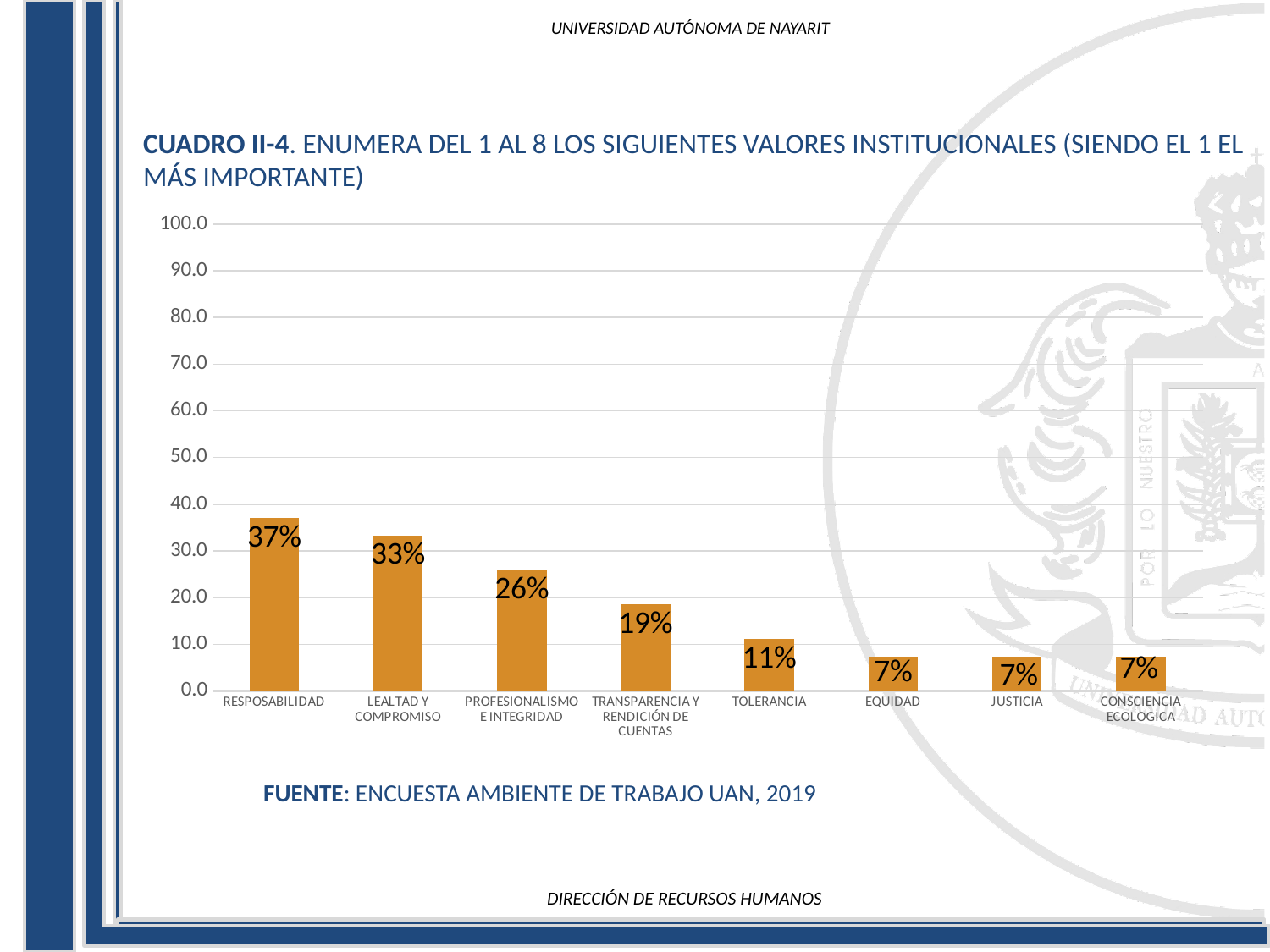
What is the source cited below the chart? ENCUESTA AMBIENTE DE TRABAJO UAN, 2019 What is the value for TRANSPARENCIA Y RENDICIÓN DE CUENTAS? 19% Which category has the highest value? RESPOSABILIDAD What kind of chart is shown on the slide? bar chart How many categories are shown on the x axis? 8 Which is larger, the value for LEALTAD Y COMPROMISO or the value for PROFESIONALISMO E INTEGRIDAD? LEALTAD Y COMPROMISO What is the value for RESPOSABILIDAD? 37% What is the difference between the values for PROFESIONALISMO E INTEGRIDAD and TOLERANCIA? 15% What is the difference between the values for RESPOSABILIDAD and LEALTAD Y COMPROMISO? 4% What is the value for TOLERANCIA? 11% Do the values rise or fall from left to right along the x axis? fall Is the value for RESPOSABILIDAD greater or less than 30.0? greater